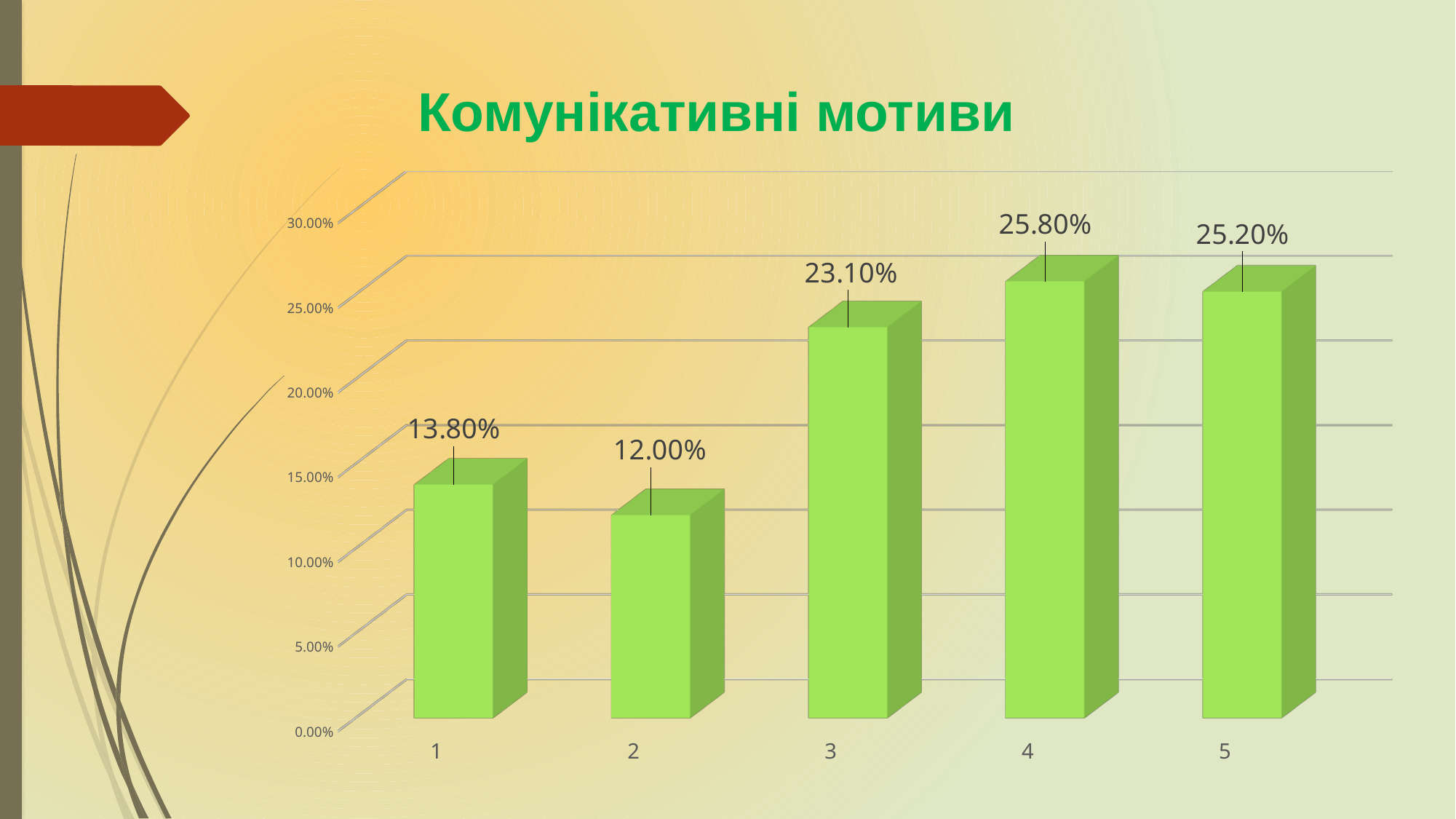
What is the value for category 3? 23.10% How many categories are shown in the chart? 5 What is the difference between the values for category 3 and category 1? 9.30% Which category has the highest value? 4 Which is larger, the value for category 1 or the value for category 2? category 1 Which category has the lowest value? 2 Is the value for category 3 greater or less than 20.00%? greater What is the value for category 1? 13.80% What is the title of the slide? Комунікативні мотиви What kind of chart is shown on the slide? bar chart What is the difference between the values for category 4 and category 2? 13.80% What is the value for category 5? 25.20%